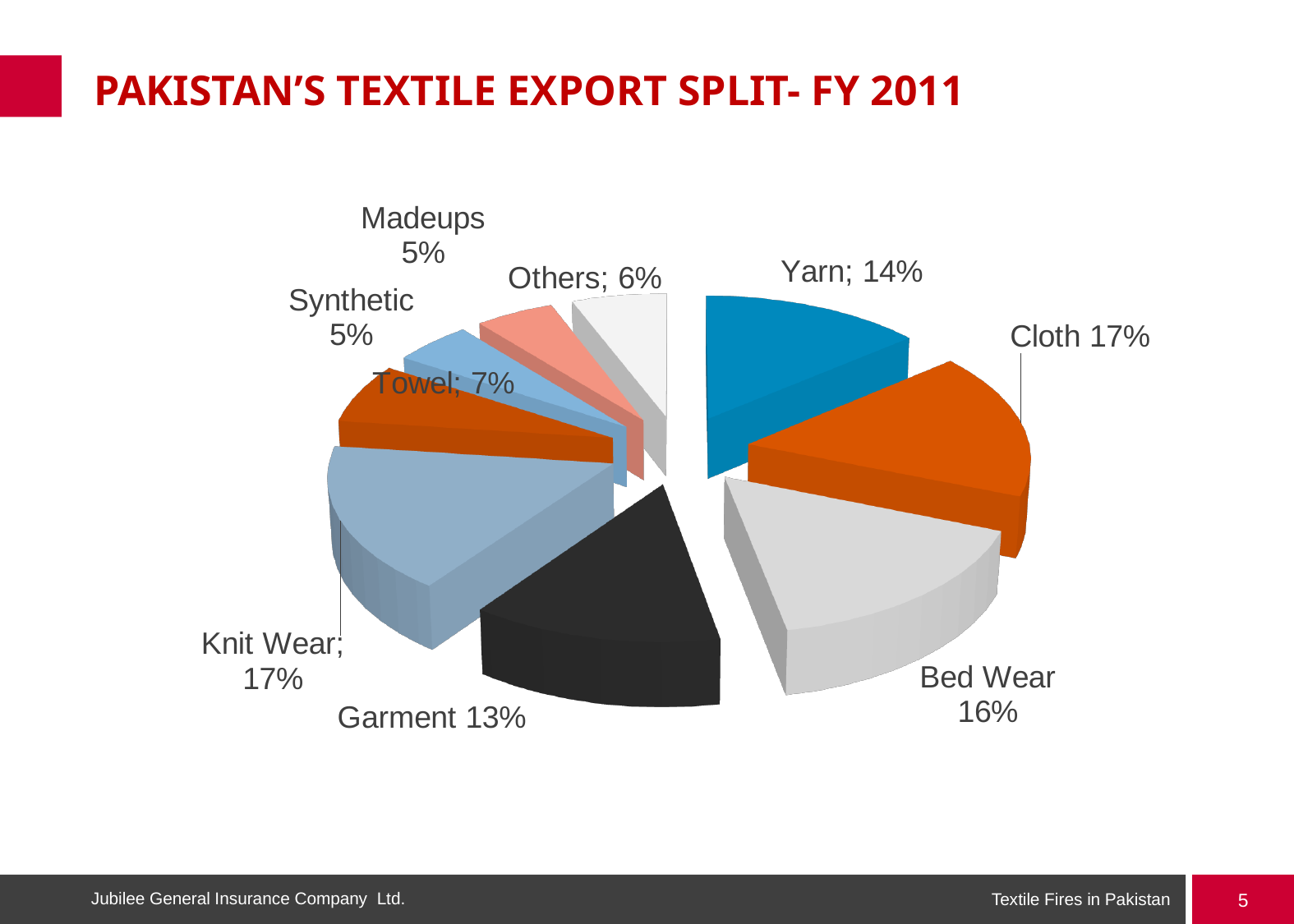
What is the value shown for Towel? 7% Which two categories share the smallest slice of the pie? Synthetic and Madeups What is the value shown for Garment? 13% Which is larger, the share for Yarn or the share for Bed Wear? Bed Wear What is the title of the chart on the slide? PAKISTAN'S TEXTILE EXPORT SPLIT- FY 2011 What is the value shown for Bed Wear? 16% What share of Pakistan's textile exports in FY 2011 is Yarn? 14% What is the difference between the Knit Wear share and the Towel share? 10% What kind of chart is shown on the slide? pie chart What is the difference between the Cloth share and the Garment share? 4% How many slices does the pie chart have? 9 What is the value shown for Others? 6%